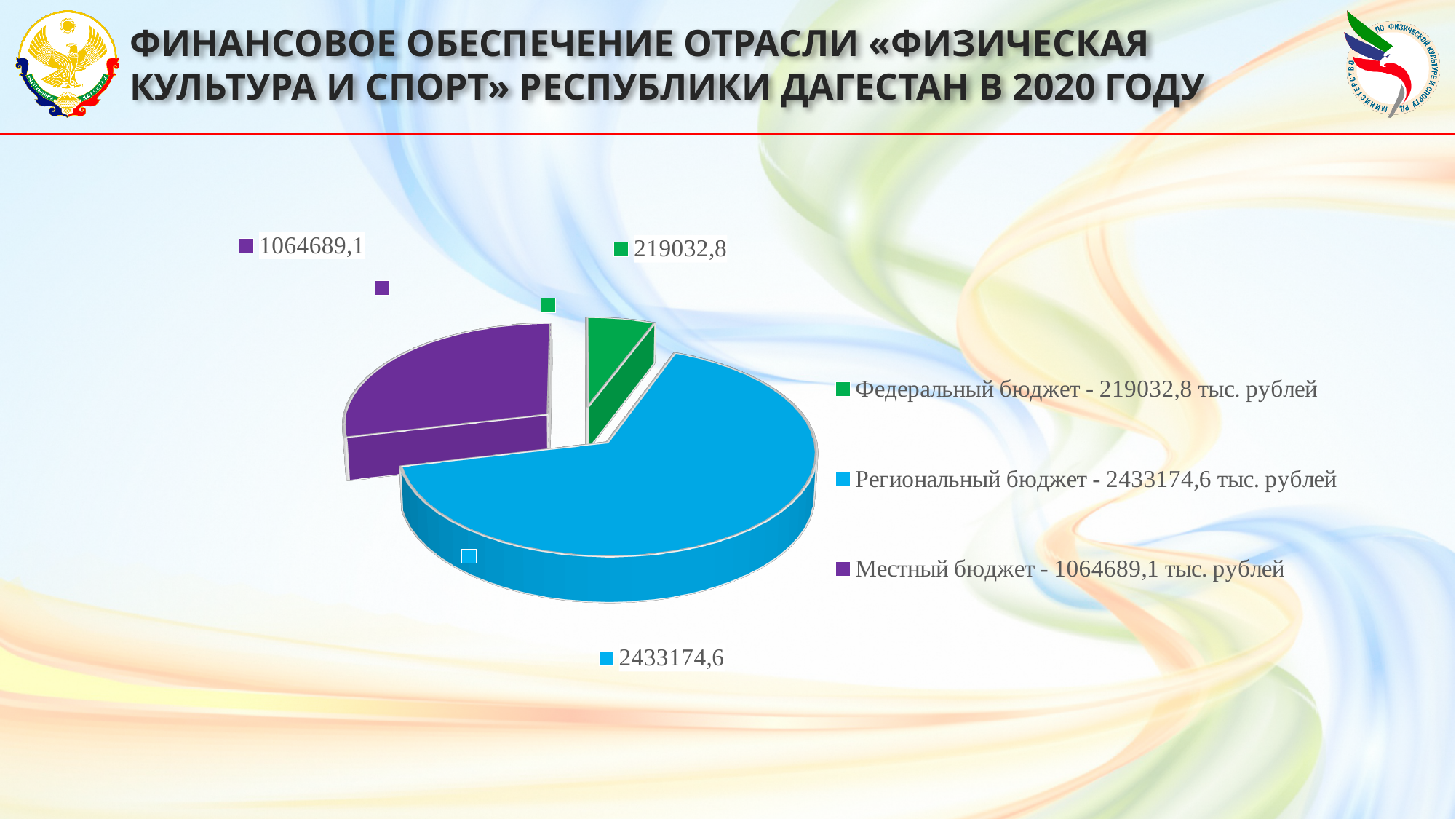
Which budget source has the smallest slice of the pie? Федеральный бюджет How many slices does the pie chart have? 3 What is the value for Федеральный бюджет? 219032,8 тыс. рублей Which is larger, Местный бюджет or Федеральный бюджет? Местный бюджет What colour is the slice for Региональный бюджет? Blue What type of chart is shown on the slide? Pie chart Which budget source has the largest slice of the pie? Региональный бюджет What is the difference between Региональный бюджет and Местный бюджет? 1368485,5 тыс. рублей What is the difference between Местный бюджет and Федеральный бюджет? 845656,3 тыс. рублей What is the total of all three budget sources shown in the pie chart? 3716896,5 тыс. рублей What is the value for Региональный бюджет? 2433174,6 тыс. рублей What is the value for Местный бюджет? 1064689,1 тыс. рублей